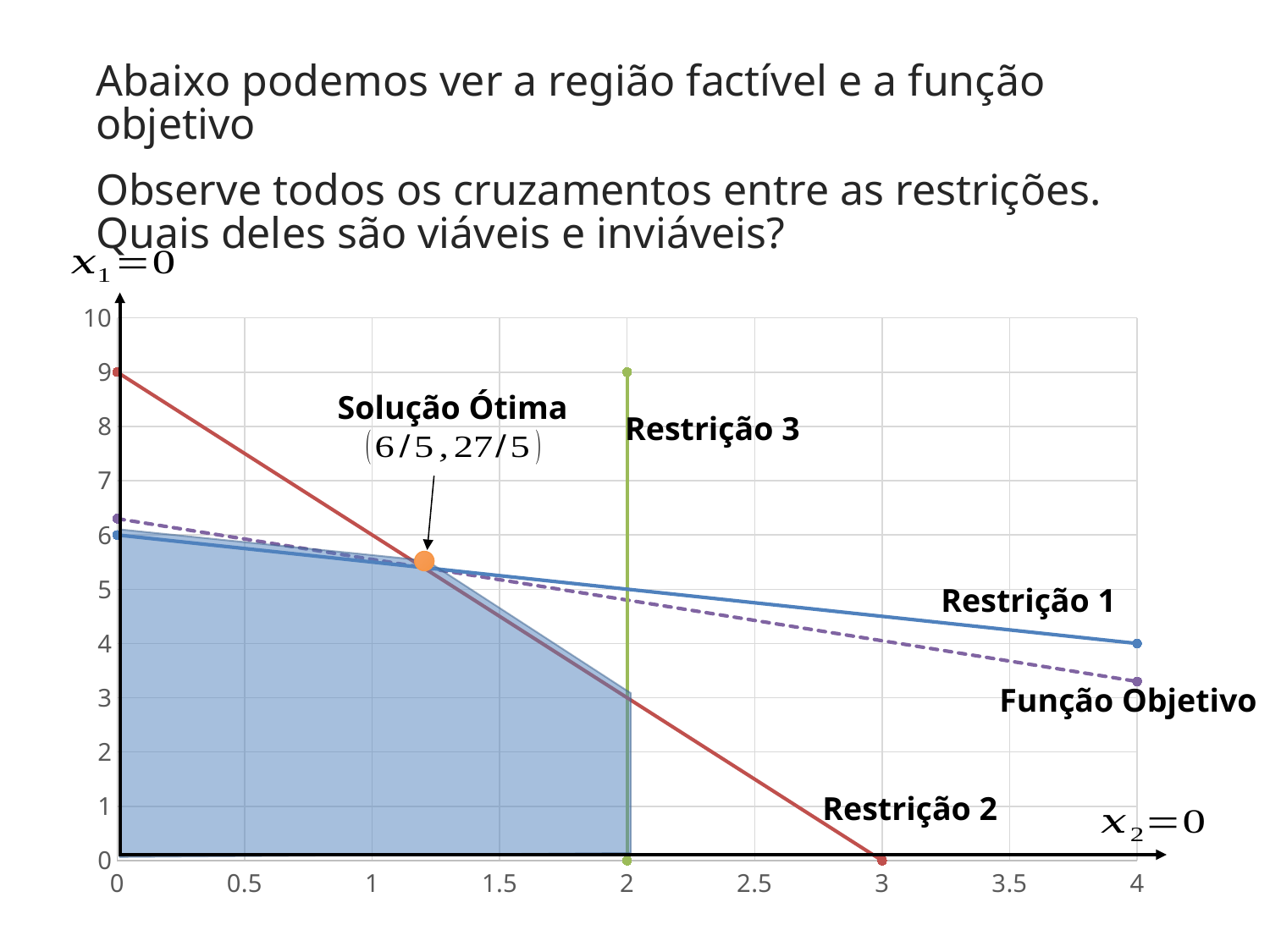
What kind of chart is shown on the slide? line chart At what horizontal-axis value is the vertical line Restrição 3 drawn? 2 Is the value of the Função Objetivo line at horizontal-axis value 4 greater or less than 4? less What is the value of the Restrição 1 line at horizontal-axis value 4? 4 At what value does the Restrição 2 line cross the horizontal axis? 3 How many labelled lines are plotted on the chart? 4 Does the Restrição 2 line rise or fall as the horizontal-axis value increases? fall What are the coordinates of the point labelled Solução Ótima? (6/5, 27/5) At horizontal-axis value 0, which line is higher: Restrição 1 or Restrição 2? Restrição 2 At what value does the Restrição 2 line cross the vertical axis? 9 Which line on the chart is drawn dashed? Função Objetivo What is the value of the Restrição 1 line at horizontal-axis value 0? 6